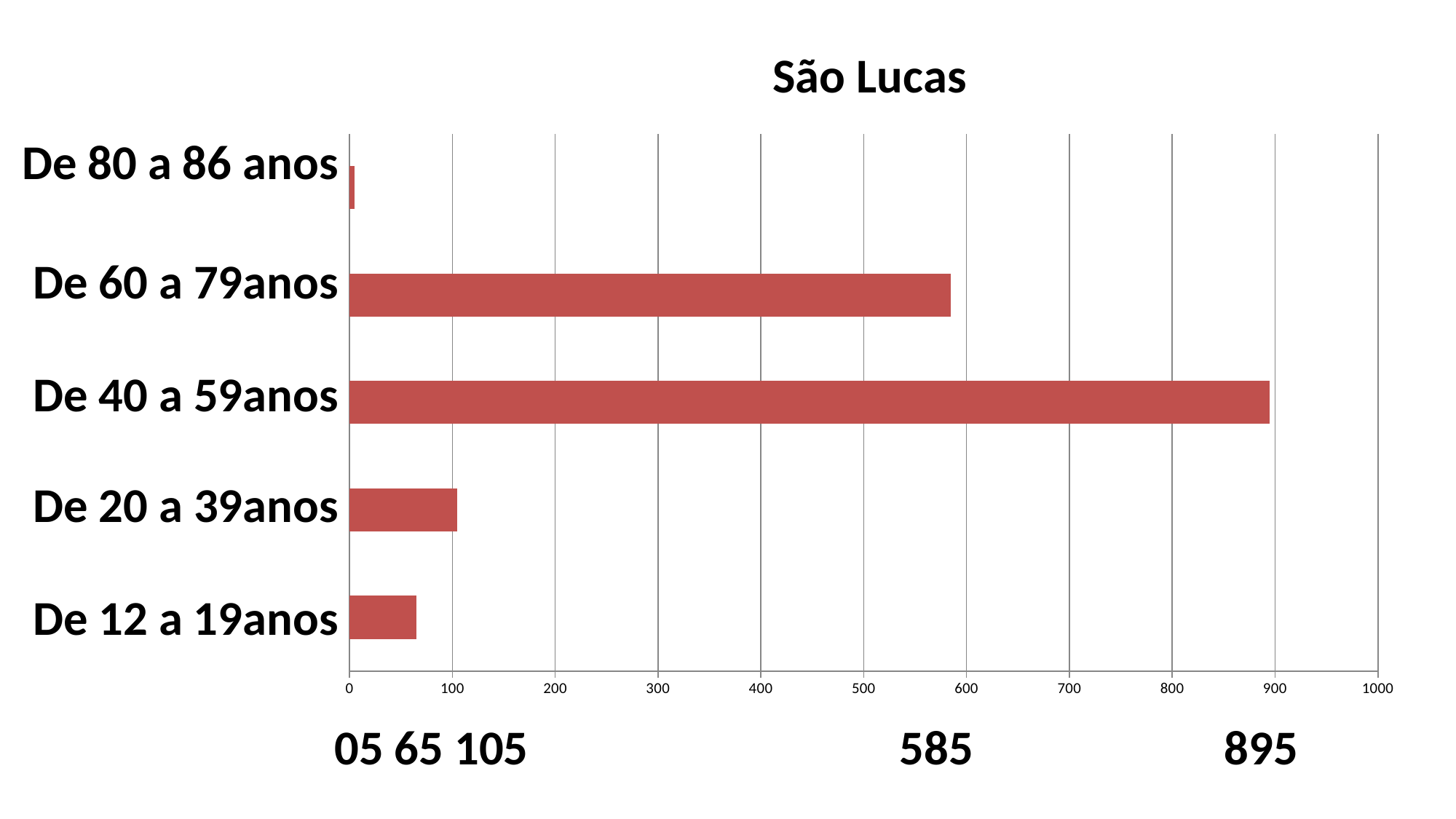
What is the value for De 40 a 59anos? 895 Which is larger, the value for De 20 a 39anos or De 12 a 19anos? De 20 a 39anos Which age category has the lowest value? De 80 a 86 anos What is the value for De 20 a 39anos? 105 Is the value for De 80 a 86 anos greater or less than 100? less What is the title of the chart? São Lucas What is the value for De 12 a 19anos? 65 What is the value for De 60 a 79anos? 585 How many age categories are shown in the chart? 5 What is the difference between the values for De 40 a 59anos and De 60 a 79anos? 310 What type of chart is shown on the slide? bar chart Which age category has the highest value? De 40 a 59anos